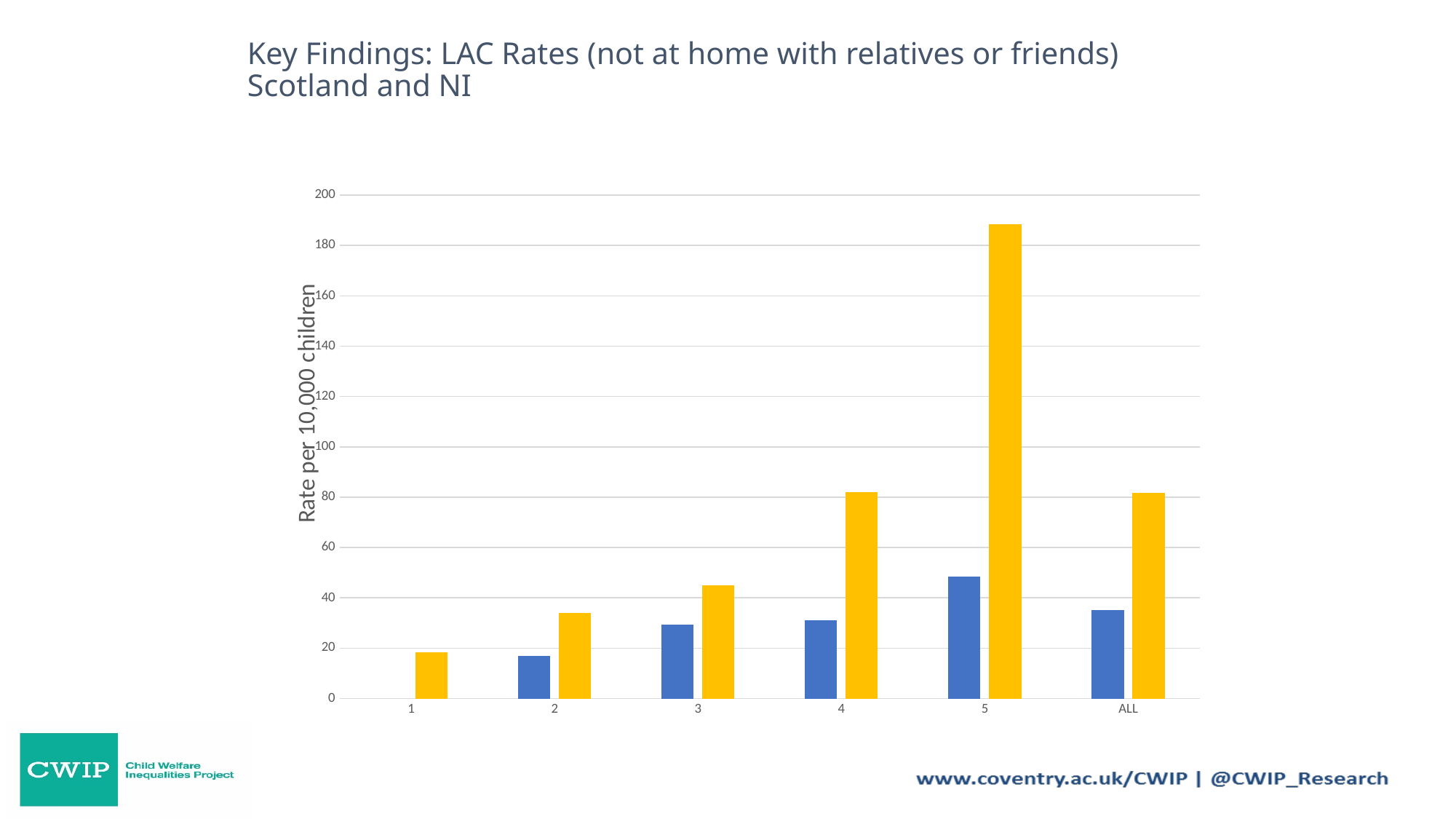
Do the yellow bars rise or fall from category 1 to category 5? rise Which category has the shortest yellow bar? 1 Which category has the tallest blue bar? 5 Is the value of the yellow bar for ALL greater or less than 60? greater For category 4, which bar is taller, the blue bar or the yellow bar? the yellow bar Is the value of the yellow bar for category 5 greater or less than 180? greater What kind of chart is shown on the slide? bar chart What is the title of the vertical axis of the chart? Rate per 10,000 children How many categories are shown on the x axis of the chart? 6 Is the value of the blue bar for category 5 greater or less than 60? less Which category has the tallest yellow bar? 5